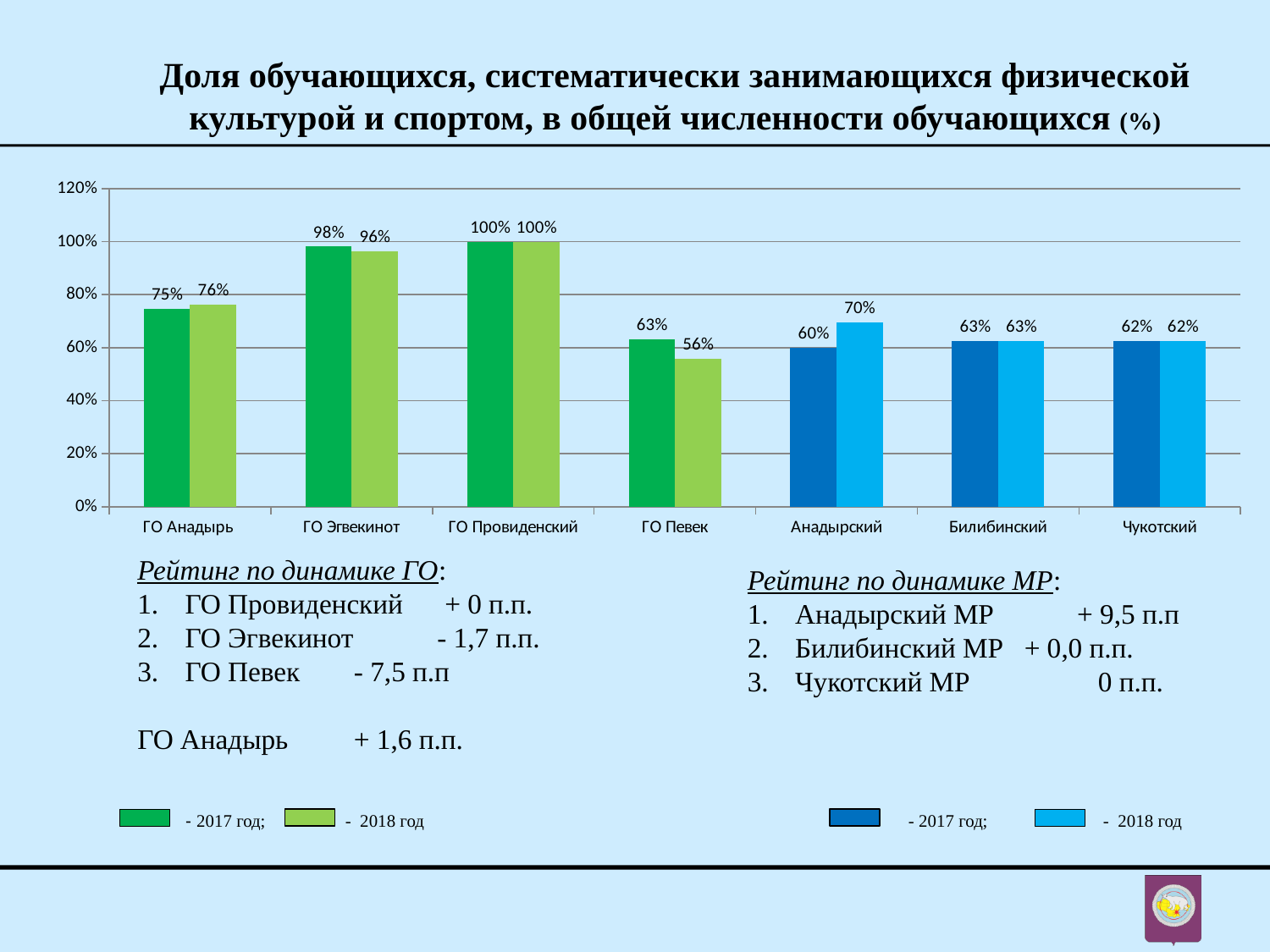
Which is larger for ГО Певек: the 2017 value or the 2018 value? 2017 Which category has the lowest 2018 value? ГО Певек What is the 2017 value for ГО Эгвекинот? 98% How many categories are shown on the x axis? 7 Which year do the lighter-coloured bars represent according to the legend? 2018 год What is the 2018 value for Анадырский? 70% What is the 2017 value for ГО Анадырь? 75% What is the difference between the 2017 and 2018 values for Анадырский? 10% What is the 2018 value for ГО Певек? 56% What is the difference between the 2017 values for ГО Эгвекинот and Чукотский? 36% Which category has the highest 2018 value? ГО Провиденский What kind of chart is shown on the slide? bar chart